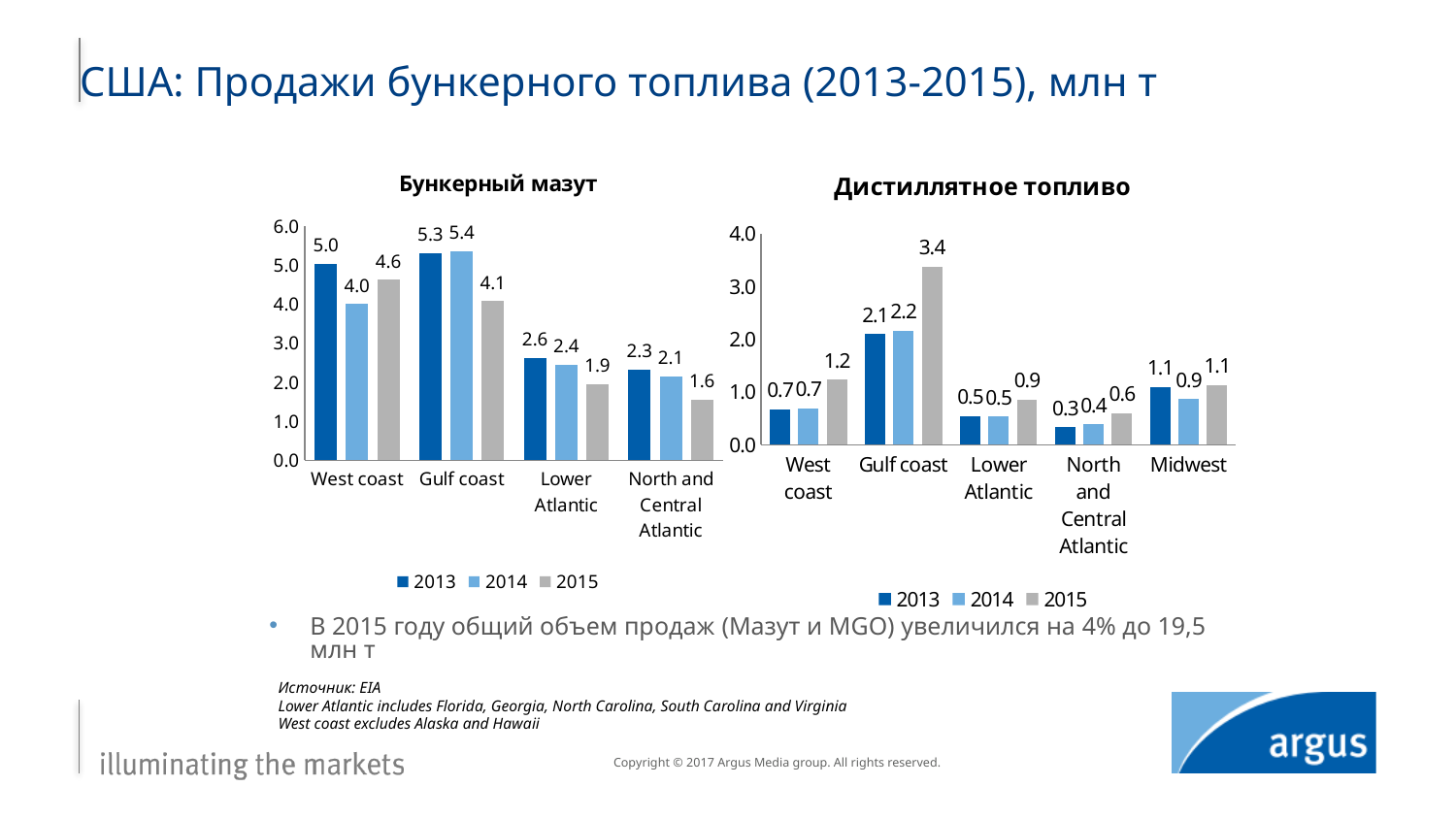
In the 'Дистиллятное топливо' chart, what is the value for Midwest in 2014? 0.9 In the 'Бункерный мазут' chart, what is the difference between the 2013 and 2015 values for Gulf coast? 1.2 How many regions are shown in the 'Дистиллятное топливо' chart? 5 In the 'Дистиллятное топливо' chart, what is the difference between the 2015 and 2013 values for West coast? 0.5 In the 'Бункерный мазут' chart, what is the value for Gulf coast in 2014? 5.4 In the 'Бункерный мазут' chart, which region has the lowest value in 2015? North and Central Atlantic How many series does the legend of the 'Бункерный мазут' chart list? 3 In the 'Дистиллятное топливо' chart, what is the value for Gulf coast in 2015? 3.4 In the 'Бункерный мазут' chart, which is larger: the 2013 value for West coast or the 2013 value for Gulf coast? Gulf coast In the 'Бункерный мазут' chart, what is the value for West coast in 2015? 4.6 In the 'Дистиллятное топливо' chart, which region has the highest value in 2013? Gulf coast What type of chart is the 'Дистиллятное топливо' chart? Bar chart